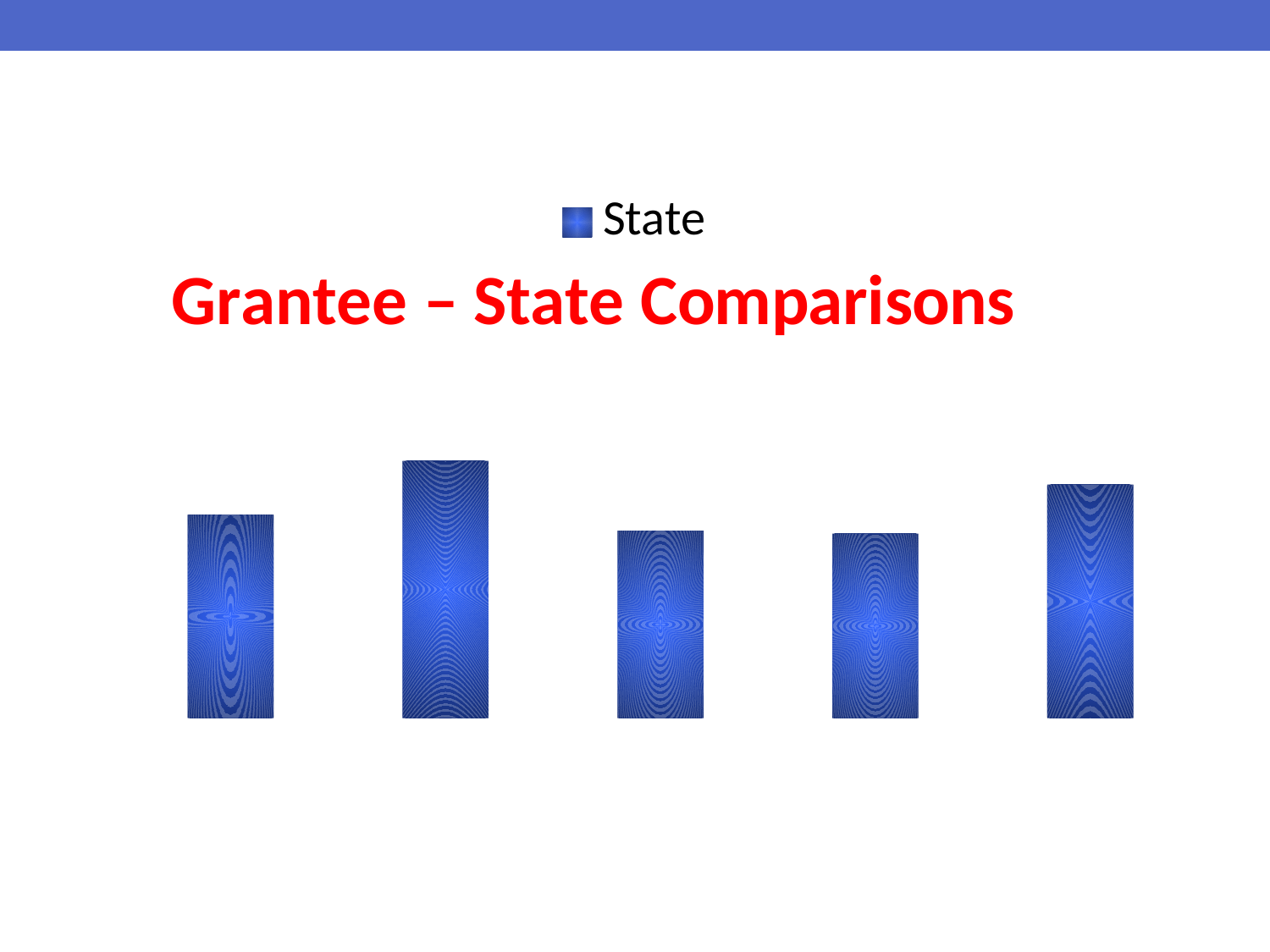
Which is taller, the first bar from the left or the fourth bar from the left? the first bar Which bar, counting from the left, is the tallest in the chart? the second bar Which is taller, the third bar from the left or the fifth bar from the left? the fifth bar Which is taller, the first bar from the left or the second bar from the left? the second bar What is the name of the series shown in the chart legend? State How many bars are plotted in the chart? 5 What is the title shown on the slide above the chart? Grantee – State Comparisons What kind of chart is shown on the slide? bar chart How many series does the chart legend list? 1